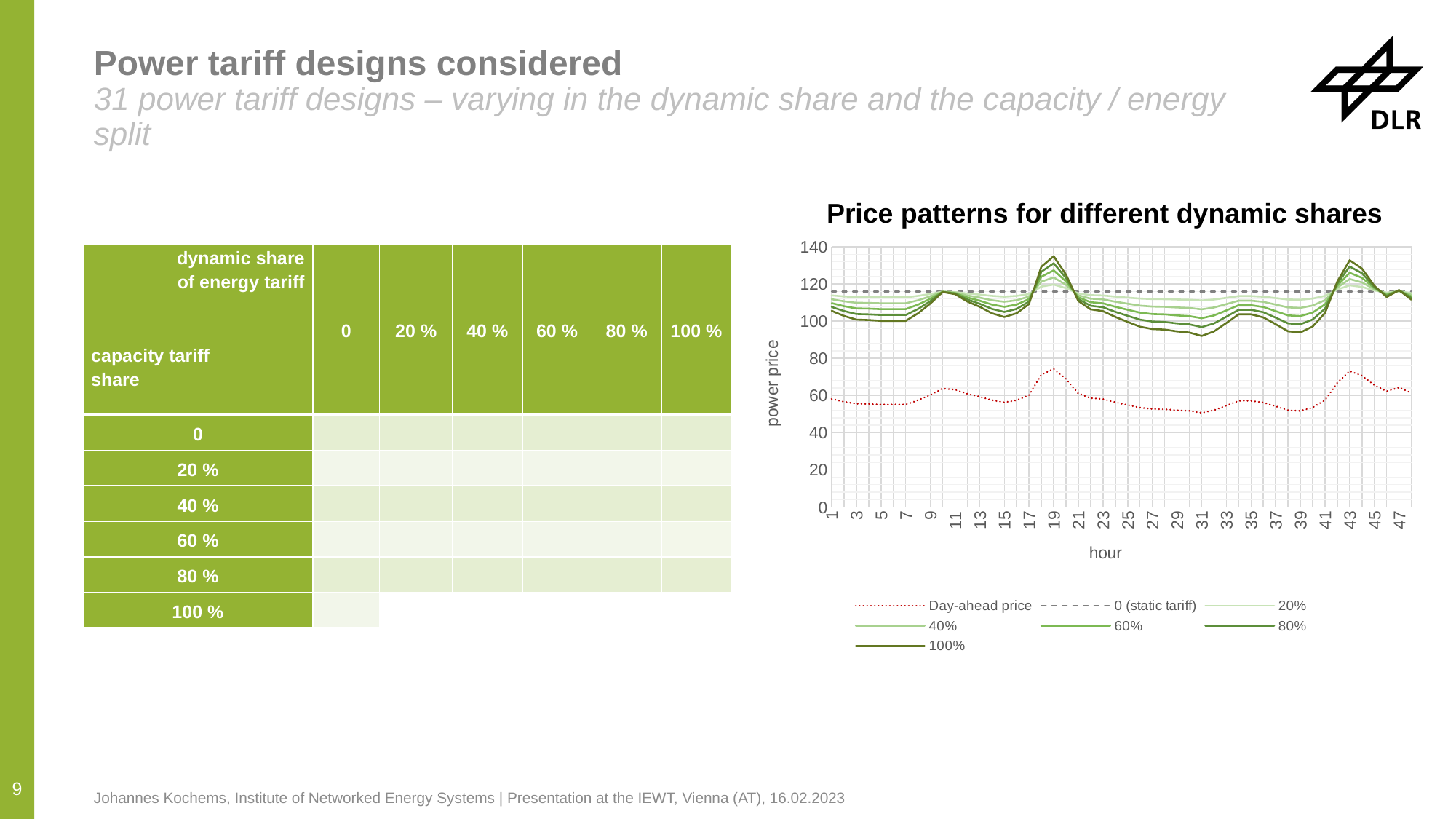
In the "Price patterns for different dynamic shares" chart, is the 0 (static tariff) line greater or less than 100? greater What kind of chart is "Price patterns for different dynamic shares"? line chart In the "Price patterns for different dynamic shares" chart, is the Day-ahead price at hour 31 greater or less than 60? less In the "Price patterns for different dynamic shares" chart, which series has the lowest values across all hours? Day-ahead price What is the highest tick value shown on the vertical axis of the "Price patterns for different dynamic shares" chart? 140 What is the label of the vertical axis in the "Price patterns for different dynamic shares" chart? power price In the "Price patterns for different dynamic shares" chart, which series reaches the highest peak value? 100% What is the title of the chart on the slide? Price patterns for different dynamic shares How many series does the legend of the "Price patterns for different dynamic shares" chart list? 7 In the "Price patterns for different dynamic shares" chart, at hour 19, which is higher: the 100% series or the Day-ahead price? 100% In the "Price patterns for different dynamic shares" chart, is the 100% series at hour 19 greater or less than 120? greater